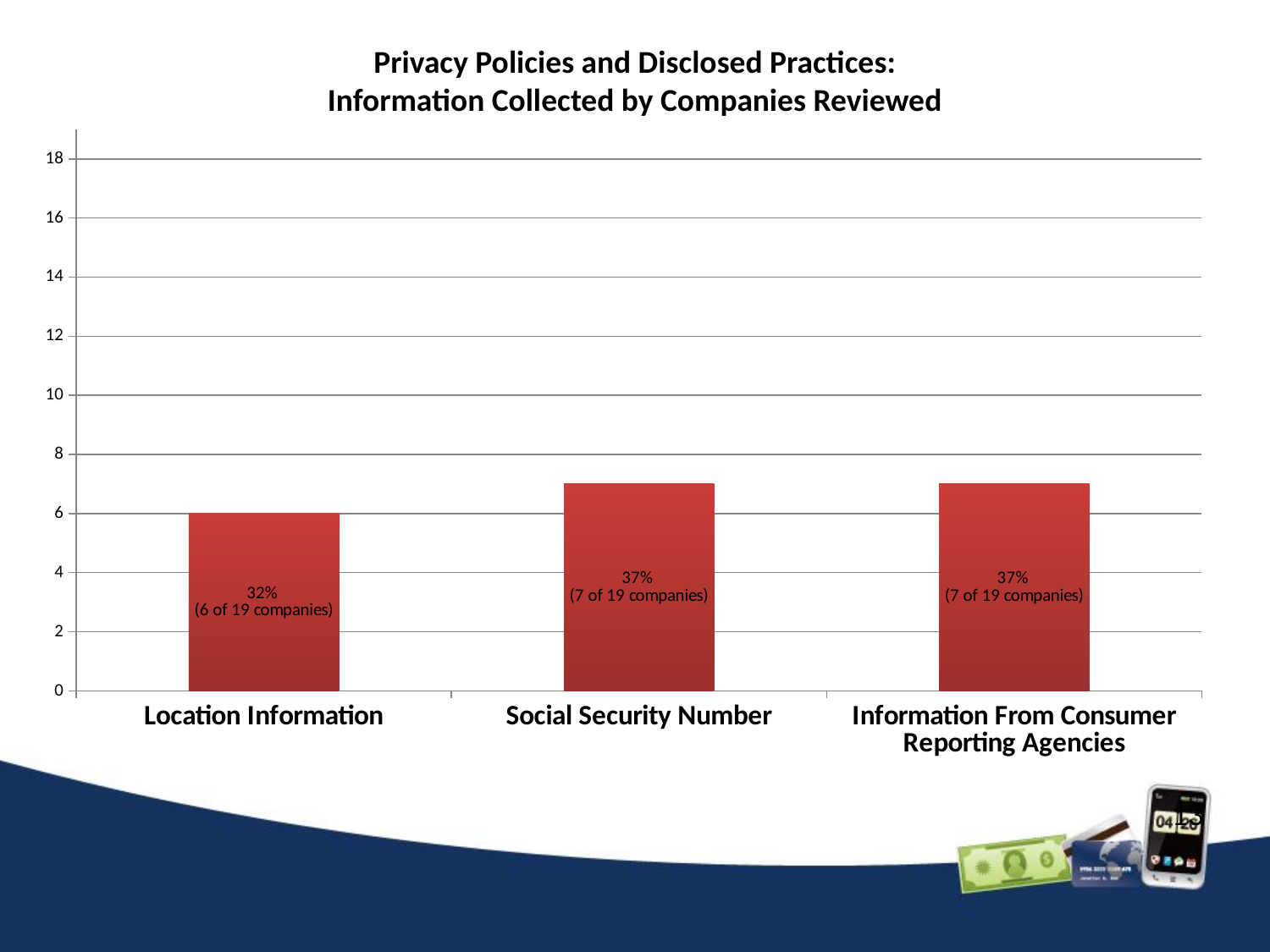
Which category has the lowest value? Location Information Is the value for Social Security Number greater or less than 8? less How many of the 19 companies collected Location Information? 6 of 19 companies What percentage is shown for Location Information? 32% What kind of chart is shown on the slide? Bar chart What is the title of the chart? Privacy Policies and Disclosed Practices: Information Collected by Companies Reviewed How many of the 19 companies collected Information From Consumer Reporting Agencies? 7 of 19 companies Which is larger, the value for Location Information or for Social Security Number? Social Security Number What is the difference in percentage points between Social Security Number and Location Information? 5 percentage points How many categories are shown on the chart? 3 What percentage is shown for Social Security Number? 37% How many more companies collected Social Security Number than Location Information? 1